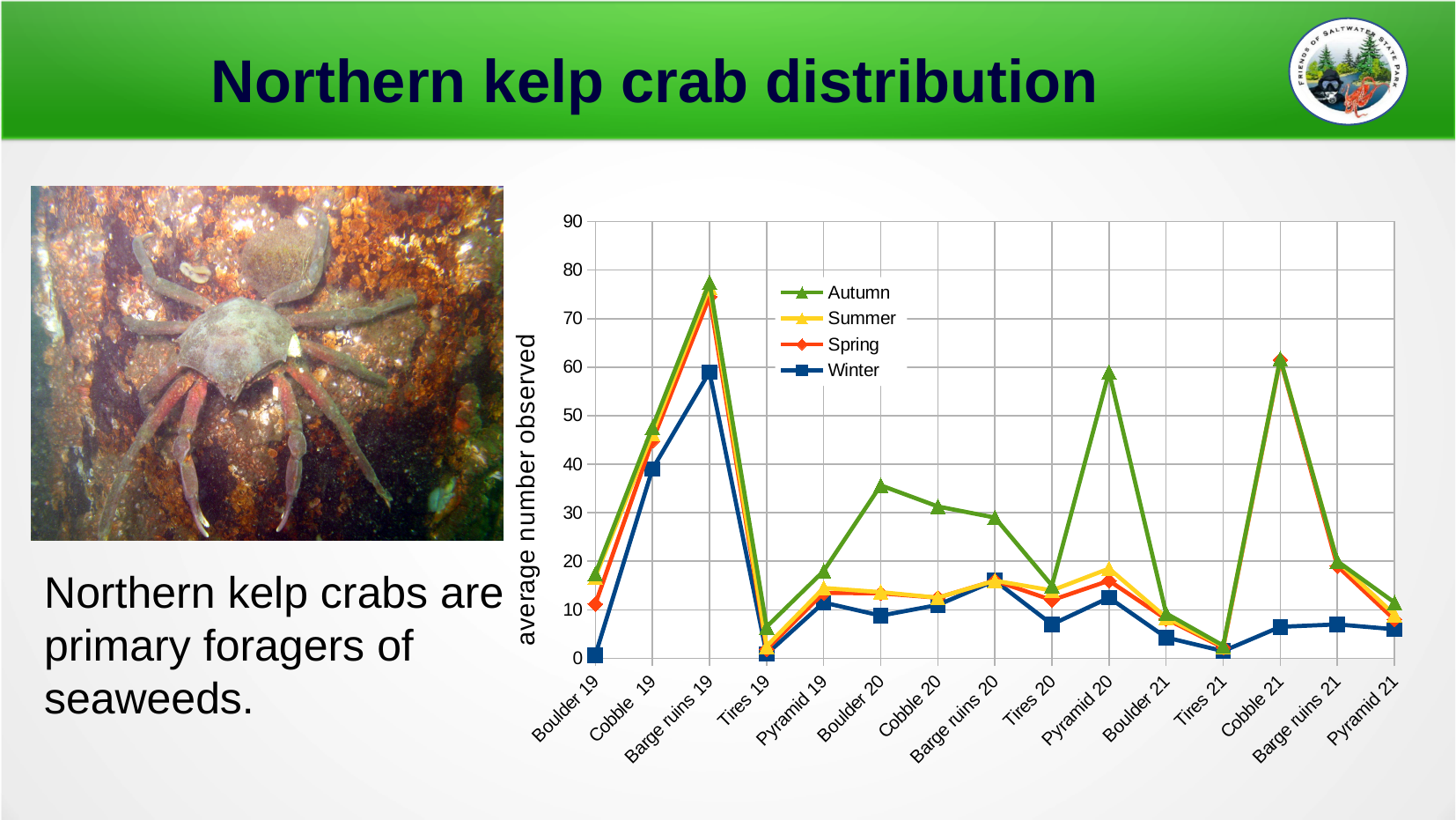
Is the Autumn value for Pyramid 20 greater or less than 50? greater What is the label of the vertical axis of the chart? average number observed Is the Winter value for Cobble 19 greater or less than 30? greater What kind of chart is shown on the slide? line chart How many series does the chart legend list? 4 Is the Autumn value for Tires 19 greater or less than 10? less At Pyramid 20, which series has the larger value, Autumn or Winter? Autumn At which category does the Autumn series reach its highest value? Barge ruins 19 At which category does the Winter series reach its highest value? Barge ruins 19 How many categories are shown along the x axis of the chart? 15 Which series is drawn in blue with square markers? Winter